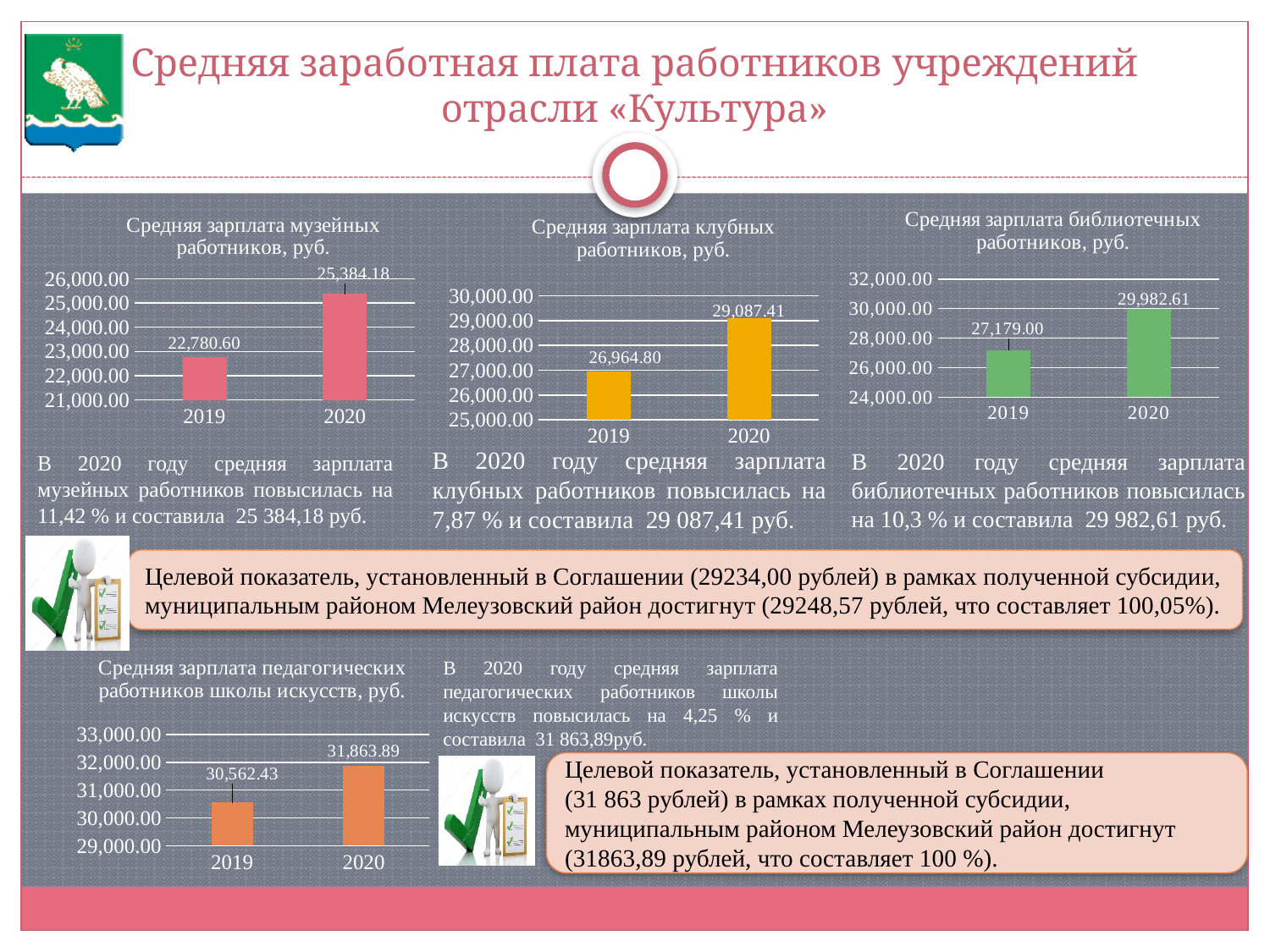
In the chart 'Средняя зарплата библиотечных работников, руб.', what is the difference between the 2020 and 2019 values? 2,803.61 In the chart 'Средняя зарплата библиотечных работников, руб.', what is the value for 2020? 29,982.61 In the chart 'Средняя зарплата музейных работников, руб.', what is the value for 2020? 25,384.18 In the chart 'Средняя зарплата музейных работников, руб.', what is the difference between the 2020 and 2019 values? 2,603.58 How many categories are shown on the x axis of the chart 'Средняя зарплата музейных работников, руб.'? 2 What kind of chart is 'Средняя зарплата библиотечных работников, руб.'? bar chart In the chart 'Средняя зарплата клубных работников, руб.', which year has the higher value? 2020 In the chart 'Средняя зарплата педагогических работников школы искусств, руб.', what is the value for 2019? 30,562.43 What colour are the bars in the chart 'Средняя зарплата библиотечных работников, руб.'? green In the chart 'Средняя зарплата клубных работников, руб.', do the values rise or fall from 2019 to 2020? rise In the chart 'Средняя зарплата педагогических работников школы искусств, руб.', which year has the lowest value? 2019 In the chart 'Средняя зарплата клубных работников, руб.', what is the value for 2019? 26,964.80